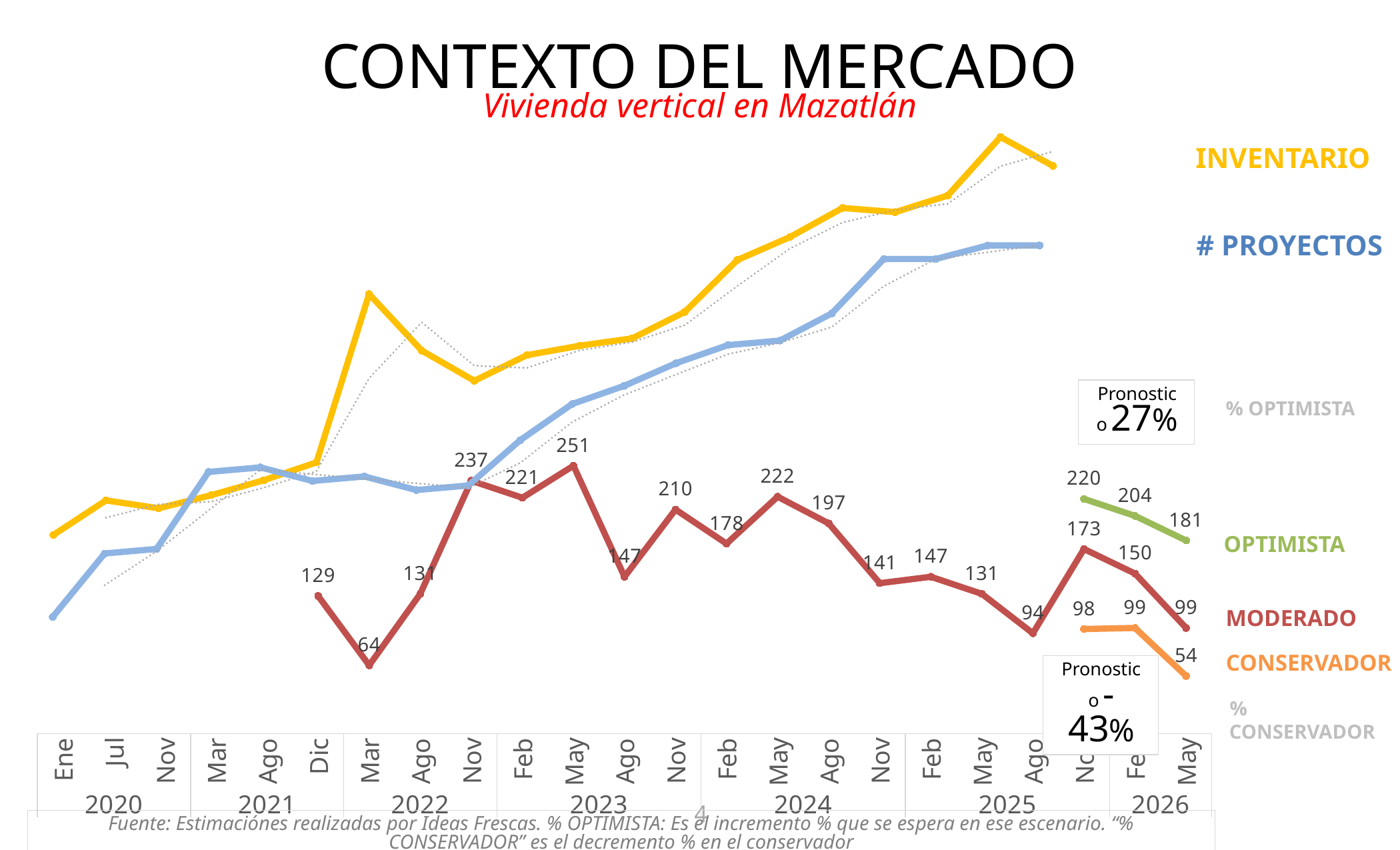
Does the OPTIMISTA series rise or fall from Nov 2025 to May 2026? fall What is the difference between the OPTIMISTA and CONSERVADOR values in May 2026? 127 In which month and year does the MODERADO series reach its lowest labelled value? Mar 2022 What is the value of the MODERADO series in May 2023? 251 What is the value of the CONSERVADOR series in May 2026? 54 What is the subtitle shown in red under the chart title? Vivienda vertical en Mazatlán In which month and year does the MODERADO series reach its highest labelled value? May 2023 What is the value of the OPTIMISTA series in May 2026? 181 How many years are labelled along the x axis of the chart? 7 What is the difference between the MODERADO values in Nov 2025 and Feb 2026? 23 What kind of chart is shown on the slide? line chart Which is larger for the MODERADO series: the value in Nov 2022 or the value in Feb 2023? Nov 2022